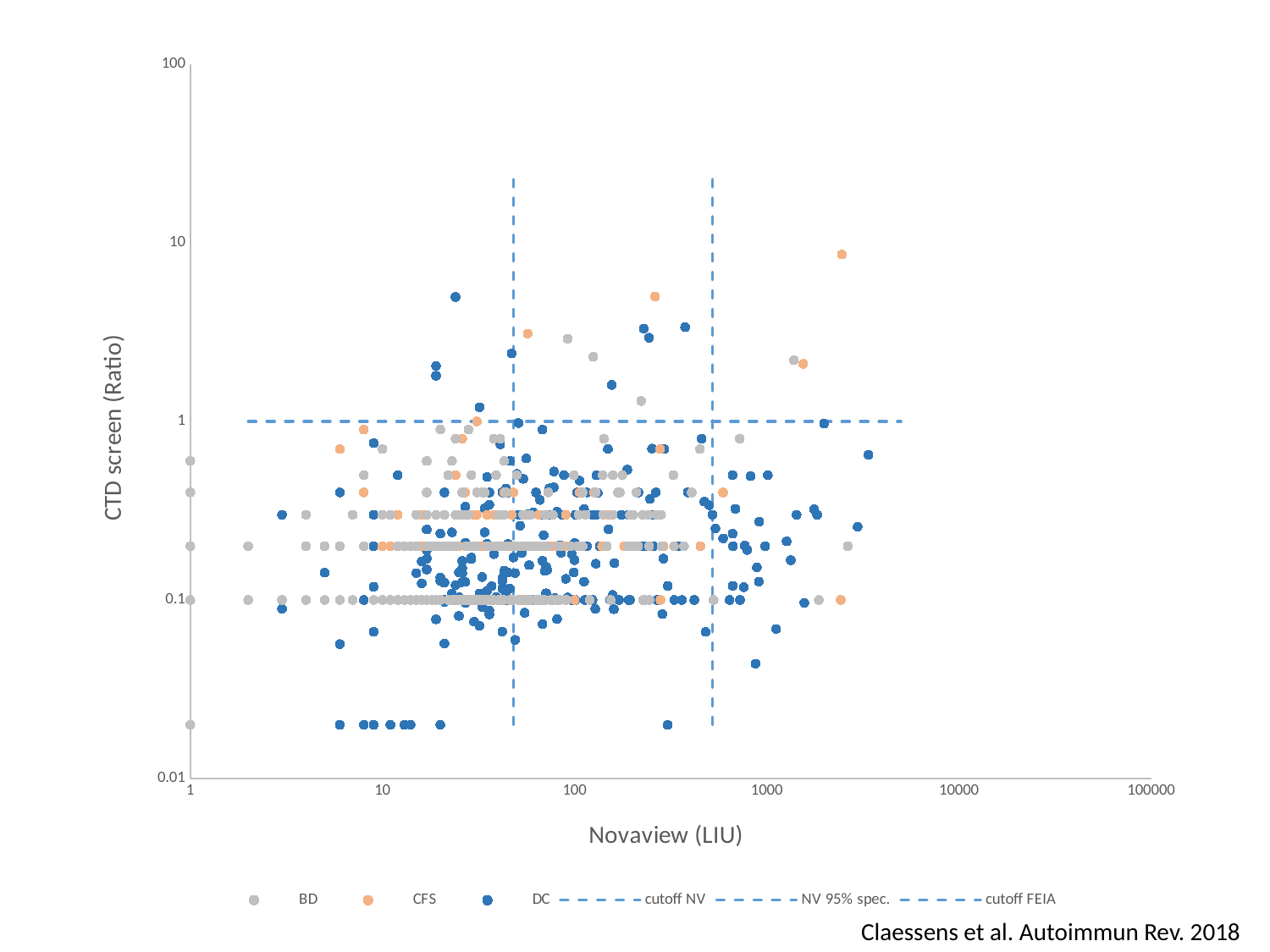
Is the CTD screen ratio of the horizontal dashed cutoff FEIA line greater or less than 0.1? greater How many entries does the legend list? 6 Which legend entry is shown with orange markers? CFS Which has the higher CTD screen ratio: the highest CFS point or the highest DC point? the highest CFS point What is the highest tick value shown on the x axis? 100000 Is the Novaview value of the NV 95% spec. dashed line greater or less than 100? greater Is the Novaview value of the highest CFS point greater or less than 1000? greater What is the title of the y axis? CTD screen (Ratio) What kind of chart is shown on the slide? scatter plot